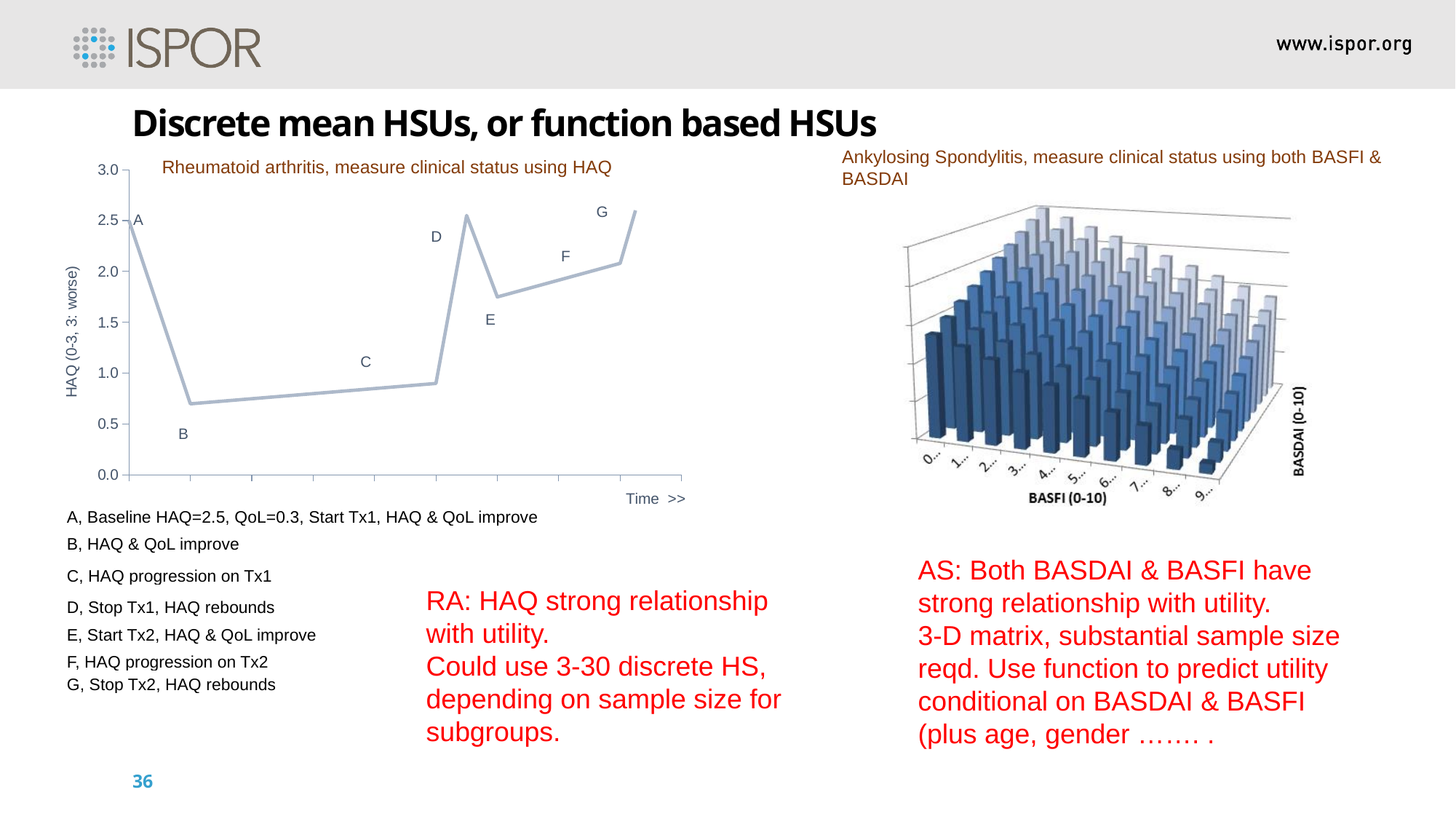
In the Rheumatoid arthritis chart, is the HAQ value at point B greater or less than 1.0? less In the Rheumatoid arthritis chart, what is the HAQ value at point A? 2.5 What is the label on the vertical axis of the Rheumatoid arthritis chart? HAQ (0-3, 3: worse) What kind of chart is the Rheumatoid arthritis chart on the left? line chart In the Rheumatoid arthritis chart, which has the higher HAQ value, point A or point B? A In the Rheumatoid arthritis chart, which labelled point has the lowest HAQ value? B In the Rheumatoid arthritis chart, does the HAQ value rise or fall from point D to point E? fall What kind of chart is the Ankylosing Spondylitis chart on the right? bar chart In the Rheumatoid arthritis chart, is the HAQ value at point E greater or less than 1.5? greater In the Rheumatoid arthritis chart, is the HAQ value at point E greater or less than 2.0? less In the Rheumatoid arthritis chart, how many labelled points are shown on the line? 7 In the Rheumatoid arthritis chart, does the HAQ value rise or fall from point A to point B? fall